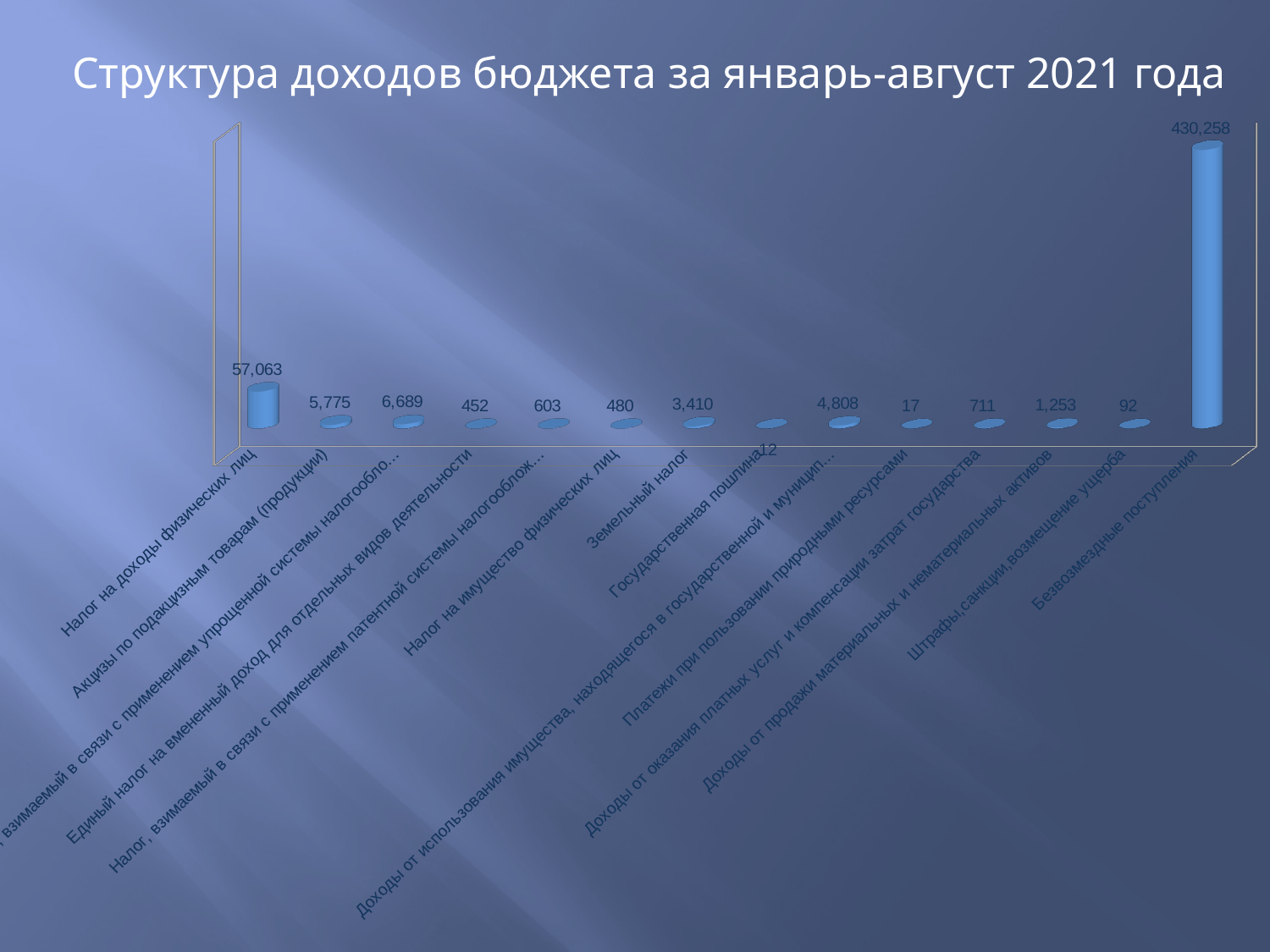
What is the difference between the values for Безвозмездные поступления and Налог на доходы физических лиц? 373,195 What is the value for Платежи при пользовании природными ресурсами? 17 What kind of chart is shown on the slide? Bar chart Which category has the lowest value? Государственная пошлина Which category has the highest value? Безвозмездные поступления What is the value for Безвозмездные поступления? 430,258 How many categories are shown in the chart? 14 Which is larger: the value for Акцизы по подакцизным товарам (продукции) or the value for Земельный налог? Акцизы по подакцизным товарам (продукции) What is the title of the chart? Структура доходов бюджета за январь-август 2021 года What is the value for Земельный налог? 3,410 What is the value for Штрафы,санкции,возмещение ущерба? 92 What is the value for Налог на доходы физических лиц? 57,063